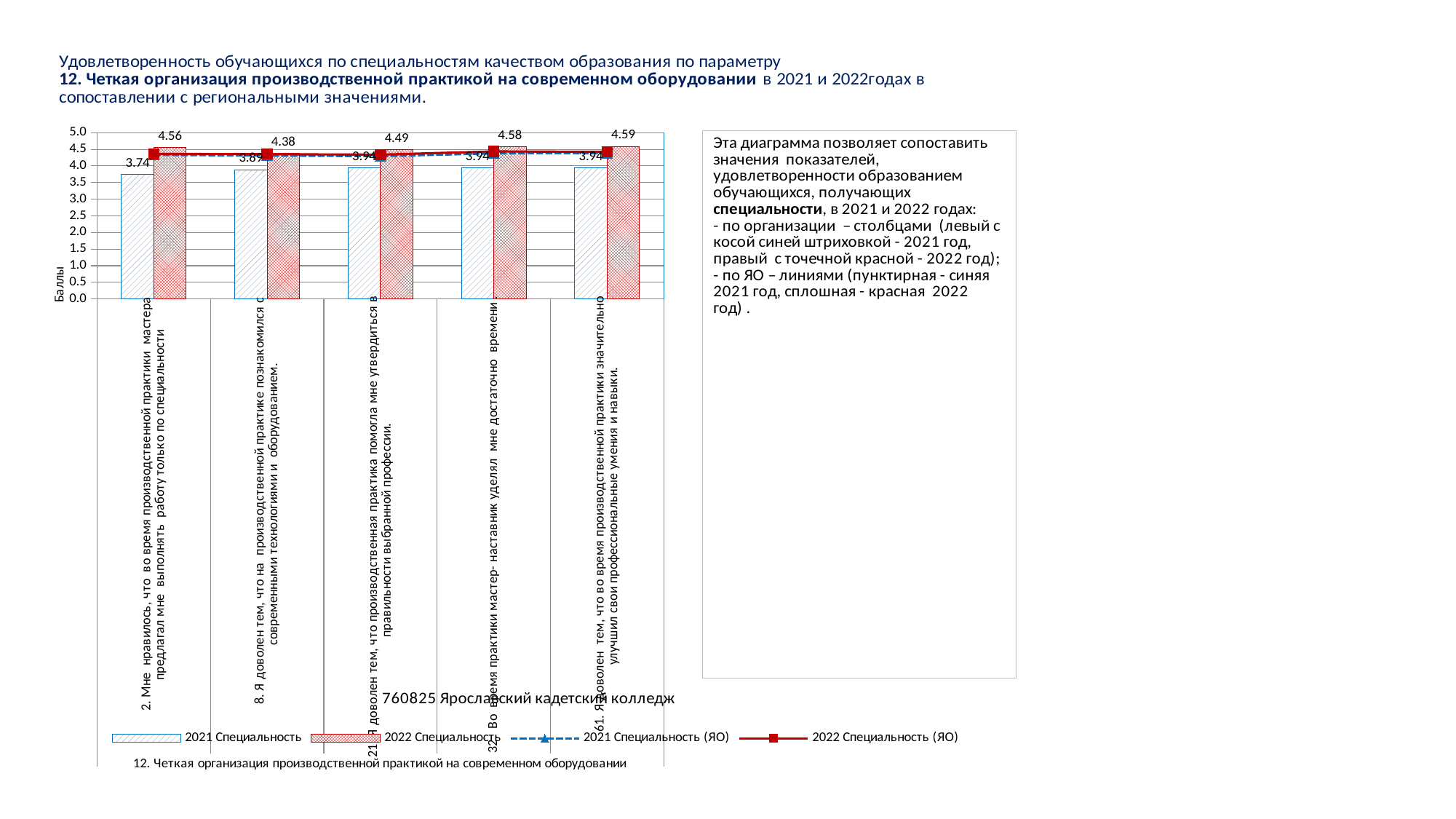
How many series does the legend list? 4 For item 32 ("Во время практики мастер-наставник уделял мне достаточно времени"), which is larger: the 2021 Специальность bar or the 2022 Специальность bar? 2022 Специальность (4.58) Is the 2021 Специальность (ЯО) line value for item 2 greater or less than 4.0? greater What is the value of the 2022 Специальность bar for item 8 ("Я доволен тем, что на производственной практике познакомился с современными технологиями и оборудованием")? 4.38 What is the value of the 2022 Специальность bar for item 21 ("Я доволен тем, что производственная практика помогла мне утвердиться в правильности выбранной профессии")? 4.49 Which item has the highest 2022 Специальность bar? 61. Я доволен тем, что во время производственной практики значительно улучшил свои профессиональные умения и навыки (4.59) What is the label of the vertical axis? Баллы Which item has the lowest 2022 Специальность bar? 8. Я доволен тем, что на производственной практике познакомился с современными технологиями и оборудованием (4.38) What is the value of the 2021 Специальность bar for item 2 ("Мне нравилось, что во время производственной практики мастера предлагал мне выполнять работу только по специальности")? 3.74 Which item has the lowest 2021 Специальность bar? 2. Мне нравилось, что во время производственной практики мастера предлагал мне выполнять работу только по специальности (3.74) What is the difference between the 2022 and 2021 Специальность bars for item 2? 0.82 How many items (categories) are shown on the x axis? 5